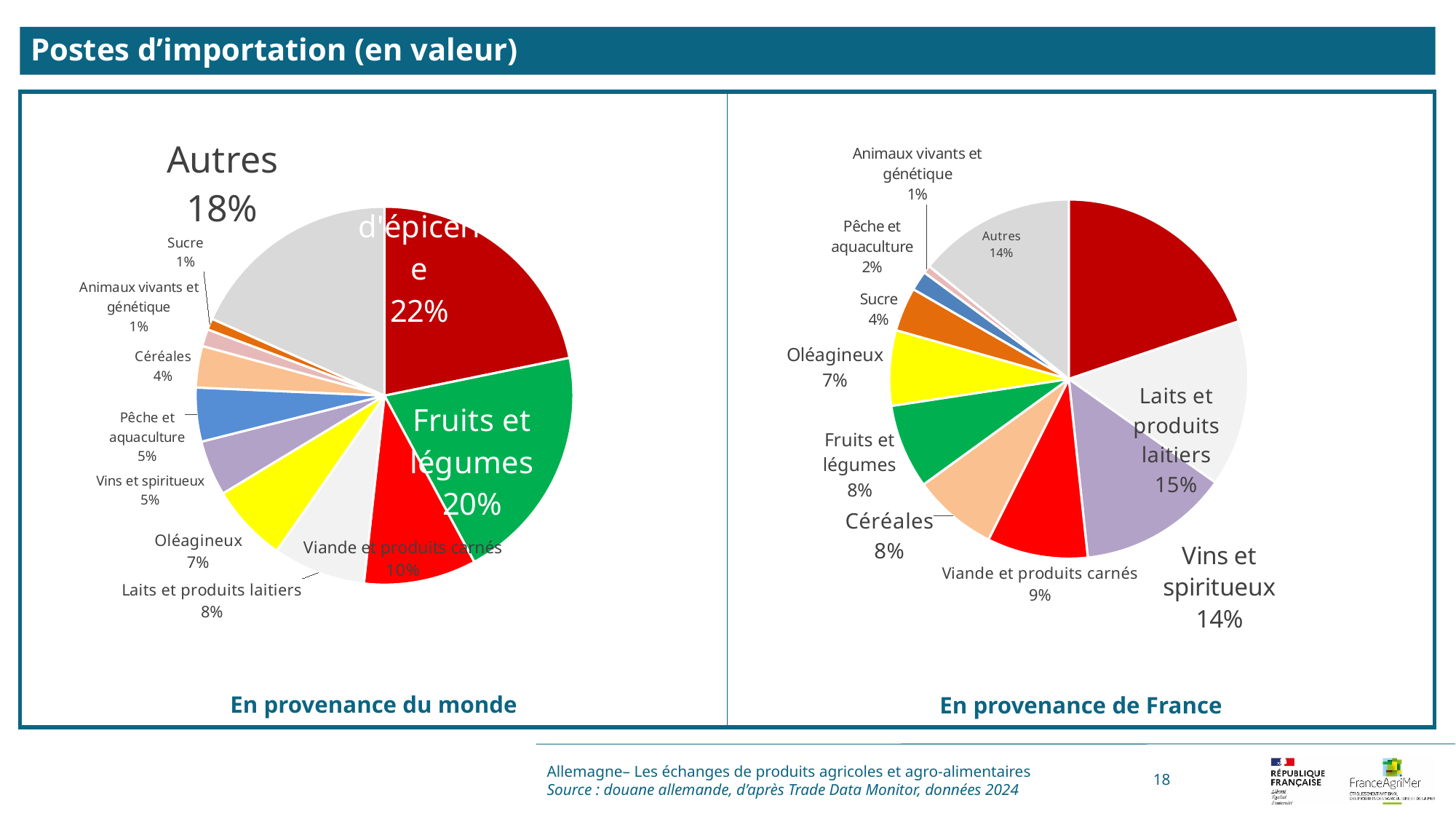
In the 'En provenance du monde' pie chart, what share do Fruits et légumes represent? 20% In the 'En provenance de France' pie chart, what share do Laits et produits laitiers represent? 15% In the 'En provenance de France' pie chart, which labelled category has the smallest share? Animaux vivants et génétique Which is larger in the 'En provenance du monde' pie chart: the share of Oléagineux or the share of Céréales? Oléagineux What type of chart is used on this slide? Pie chart In the 'En provenance du monde' pie chart, what is the difference between the shares of Fruits et légumes and Viande et produits carnés? 10 percentage points In the 'En provenance du monde' pie chart, what is the share of Autres? 18% In the 'En provenance de France' pie chart, what is the share of Vins et spiritueux? 14% What is the title of the slide? Postes d'importation (en valeur) How many slices does the 'En provenance de France' pie chart have? 11 Is the share of Vins et spiritueux larger in the 'En provenance du monde' chart or in the 'En provenance de France' chart? En provenance de France In the 'En provenance de France' pie chart, what is the difference between the shares of Laits et produits laitiers and Oléagineux? 8 percentage points